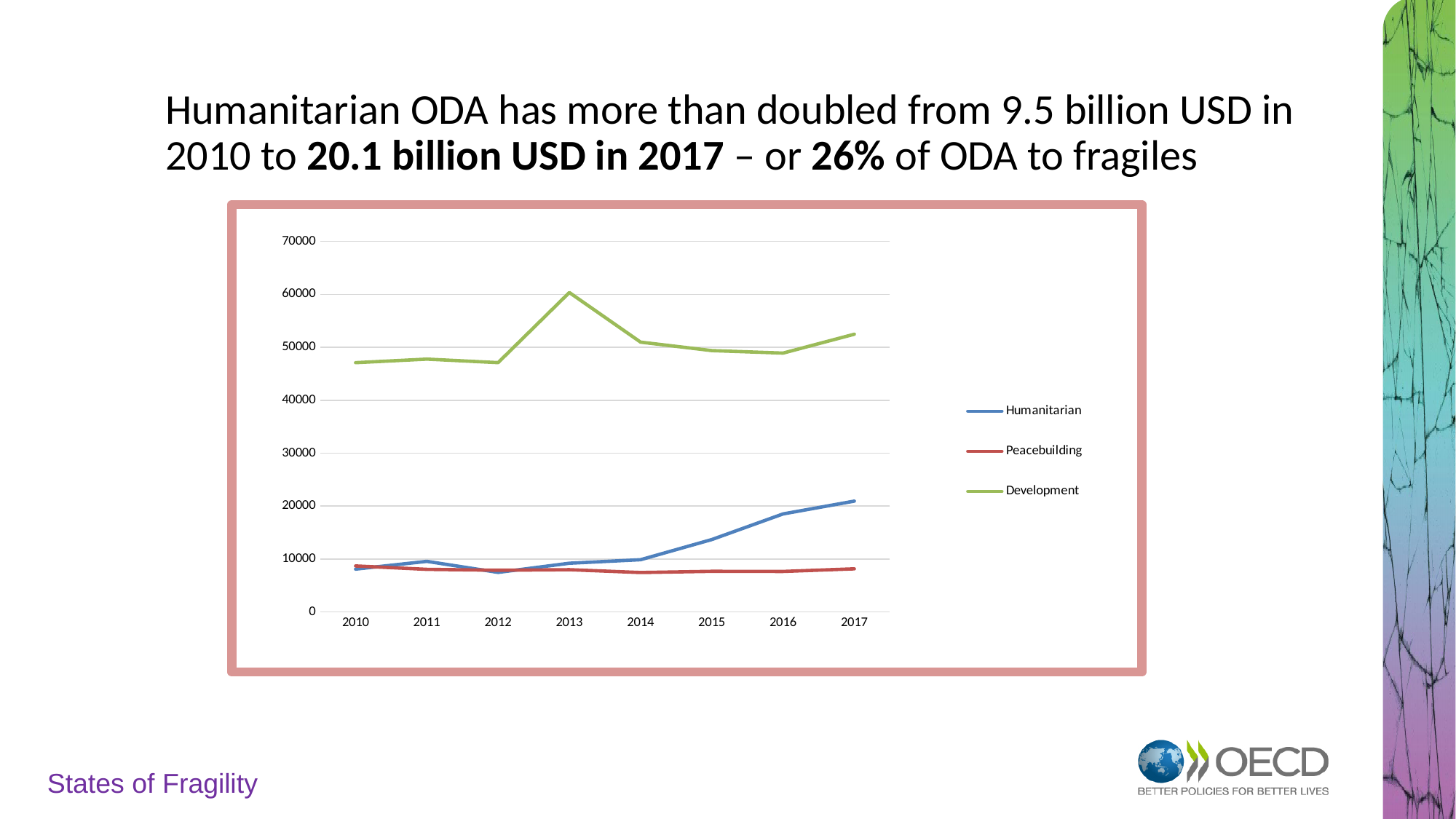
In which year does the Development series reach its highest value? 2013 In which year does the Humanitarian series reach its highest value? 2017 Which series has the larger value in 2017, Humanitarian or Peacebuilding? Humanitarian Is the value for Peacebuilding in 2017 greater or less than 10000? less Which series is drawn in green on the chart? Development Is the value for Development in 2010 greater or less than 50000? less Is the value for Humanitarian in 2016 greater or less than 10000? greater How many years are plotted along the x axis of the chart? 8 What kind of chart is shown on the slide? line chart Does the Humanitarian series rise or fall between 2012 and 2017? rise How many series does the chart's legend list? 3